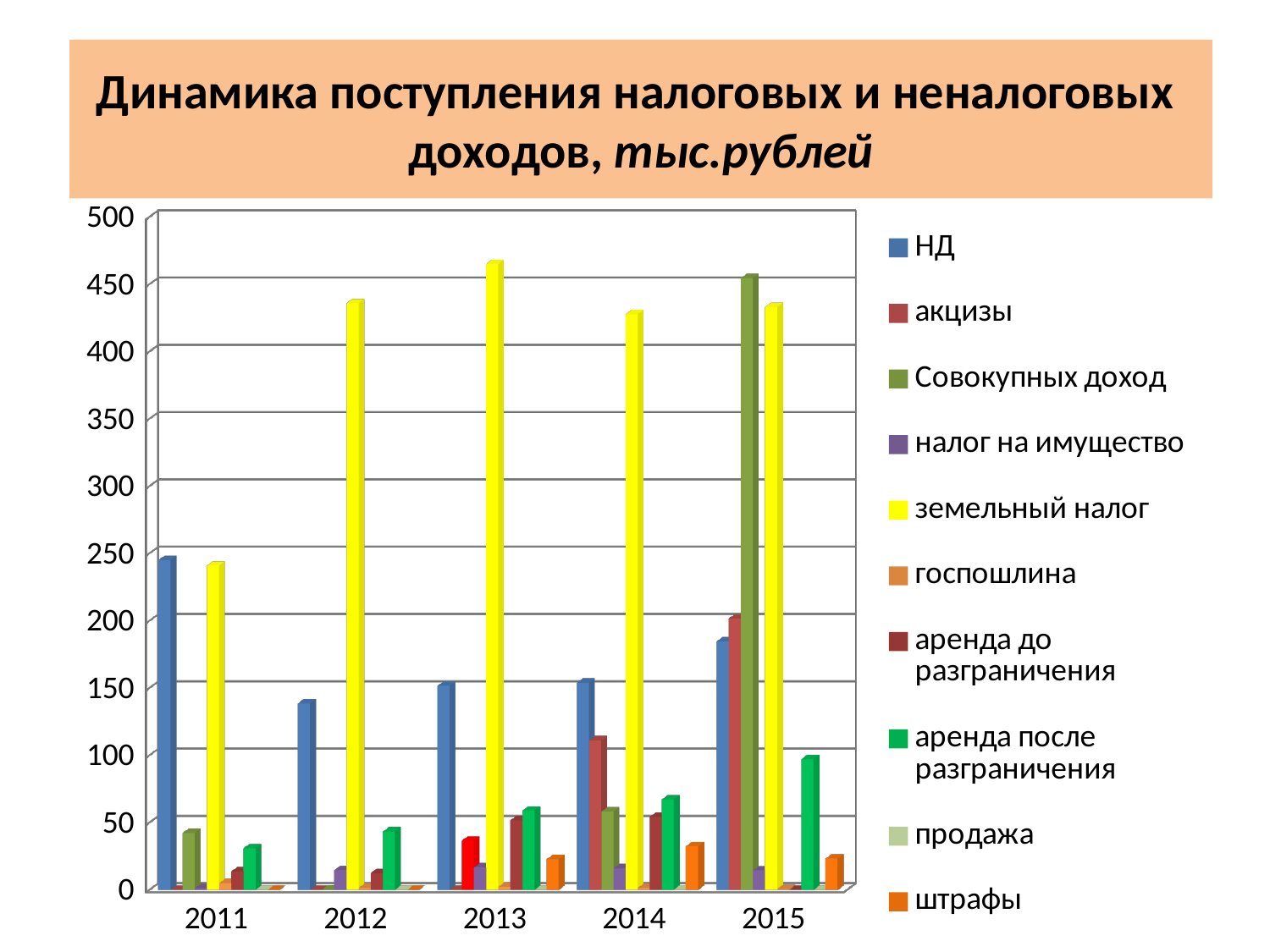
How many series does the legend list? 10 Is the value for Совокупных доход in 2015 greater or less than 400? greater Is the value for земельный налог in 2013 greater or less than 450? greater Is the value for НД in 2012 greater or less than 150? less How many years are shown along the x axis? 5 In 2014, which is larger: акцизы or аренда после разграничения? акцизы What kind of chart is shown on the slide? bar chart What is the unit of measurement given in the chart title? тыс.рублей In which year is the value for земельный налог the highest? 2013 In which year is the value for НД the highest? 2011 In which year is the value for земельный налог the lowest? 2011